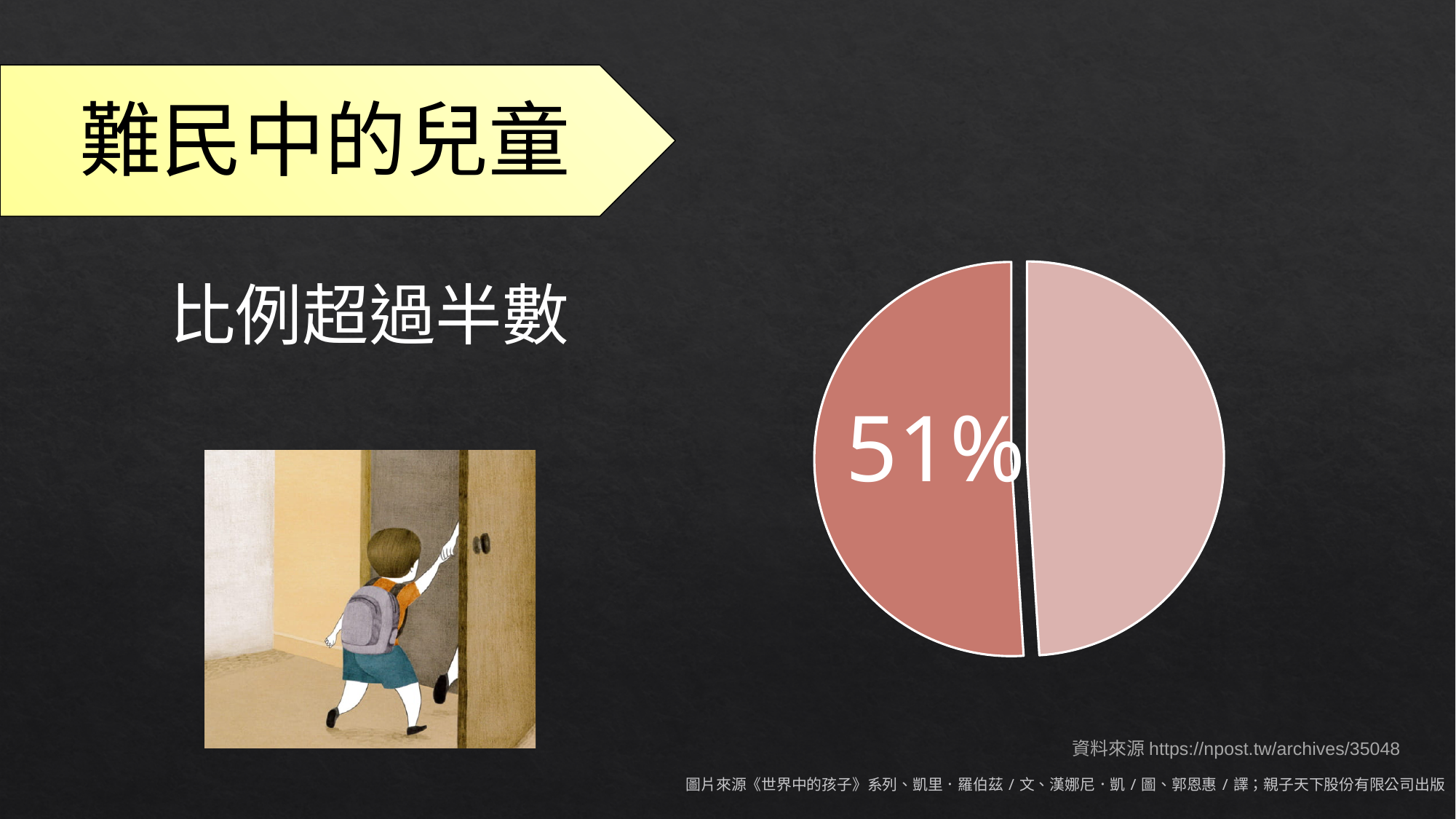
Does the pie chart include a legend? No What percentage is printed on the darker red slice of the pie chart? 51% What share of the pie does the labelled slice represent? 51% Is the value of the labelled slice greater or less than 50%? greater What colour is the slice labelled 51%? Darker red Which slice of the pie chart is larger, the darker red slice or the lighter pink slice? The darker red slice How many slices does the pie chart have? 2 What kind of chart is shown on the slide? Pie chart